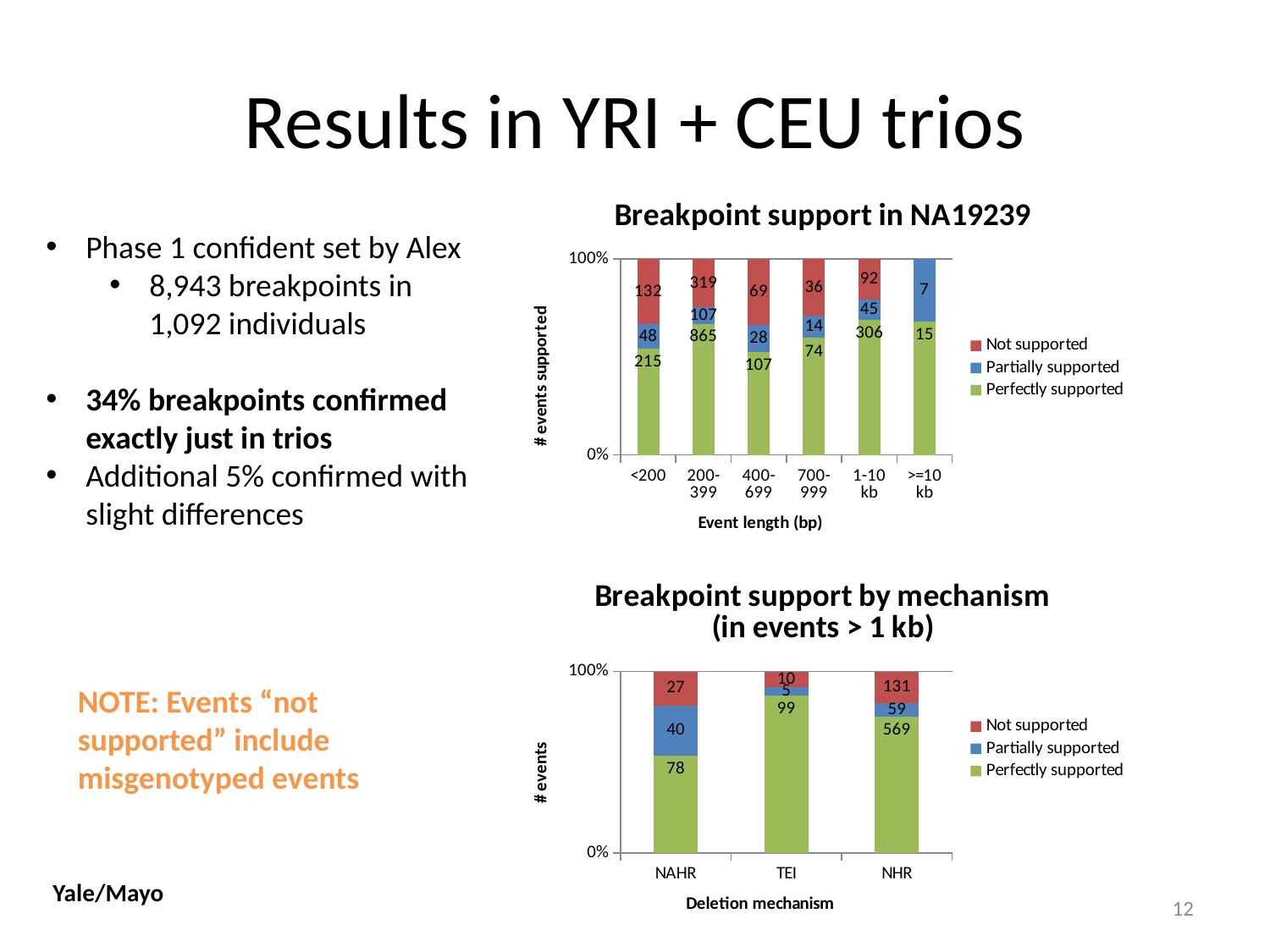
In the 'Breakpoint support by mechanism (in events > 1 kb)' chart, what is the total number of events for NAHR across all three series? 145 What kind of chart is 'Breakpoint support by mechanism (in events > 1 kb)'? Stacked bar chart In the 'Breakpoint support in NA19239' chart, what is the 'Not supported' value for the <200 event length category? 132 In the 'Breakpoint support in NA19239' chart, how many event length categories are shown on the x axis? 6 In the 'Breakpoint support in NA19239' chart, what is the difference between the 'Perfectly supported' values for 400-699 and 700-999? 33 In the 'Breakpoint support by mechanism (in events > 1 kb)' chart, what is the 'Partially supported' value for TEI? 5 In the 'Breakpoint support by mechanism (in events > 1 kb)' chart, which mechanism has the lowest 'Not supported' value? TEI In the 'Breakpoint support in NA19239' chart, what is the 'Perfectly supported' value for the 200-399 event length category? 865 How many series does the legend of the 'Breakpoint support by mechanism (in events > 1 kb)' chart list? 3 In the 'Breakpoint support in NA19239' chart, which event length category has the highest 'Perfectly supported' value? 200-399 In the 'Breakpoint support by mechanism (in events > 1 kb)' chart, what is the 'Perfectly supported' value for NHR? 569 In the 'Breakpoint support in NA19239' chart, what is the 'Partially supported' value for the 1-10 kb category? 45